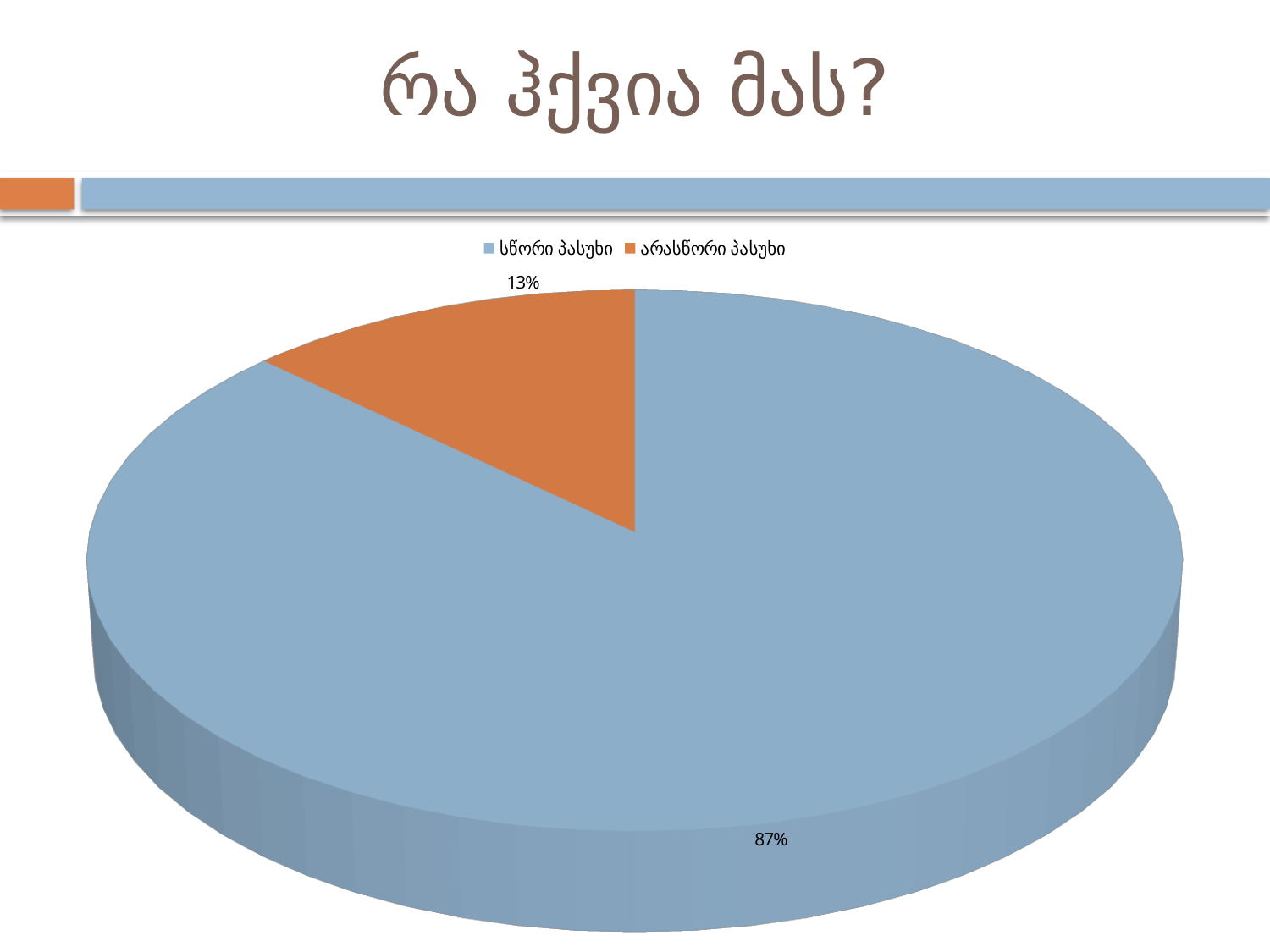
What share of the pie is labelled სწორი პასუხი? 87% What share of the pie is labelled არასწორი პასუხი? 13% How many slices does the pie chart have? 2 What colour is the არასწორი პასუხი slice? Orange Which slice of the pie is the largest? სწორი პასუხი What colour is the სწორი პასუხი slice? Blue Which is larger, the სწორი პასუხი slice or the არასწორი პასუხი slice? სწორი პასუხი Which slice of the pie is the smallest? არასწორი პასუხი What kind of chart is shown on the slide? Pie chart What is the total of the two percentages shown on the pie chart? 100% How many entries does the legend list? 2 What is the difference in percentage points between the სწორი პასუხი slice and the არასწორი პასუხი slice? 74